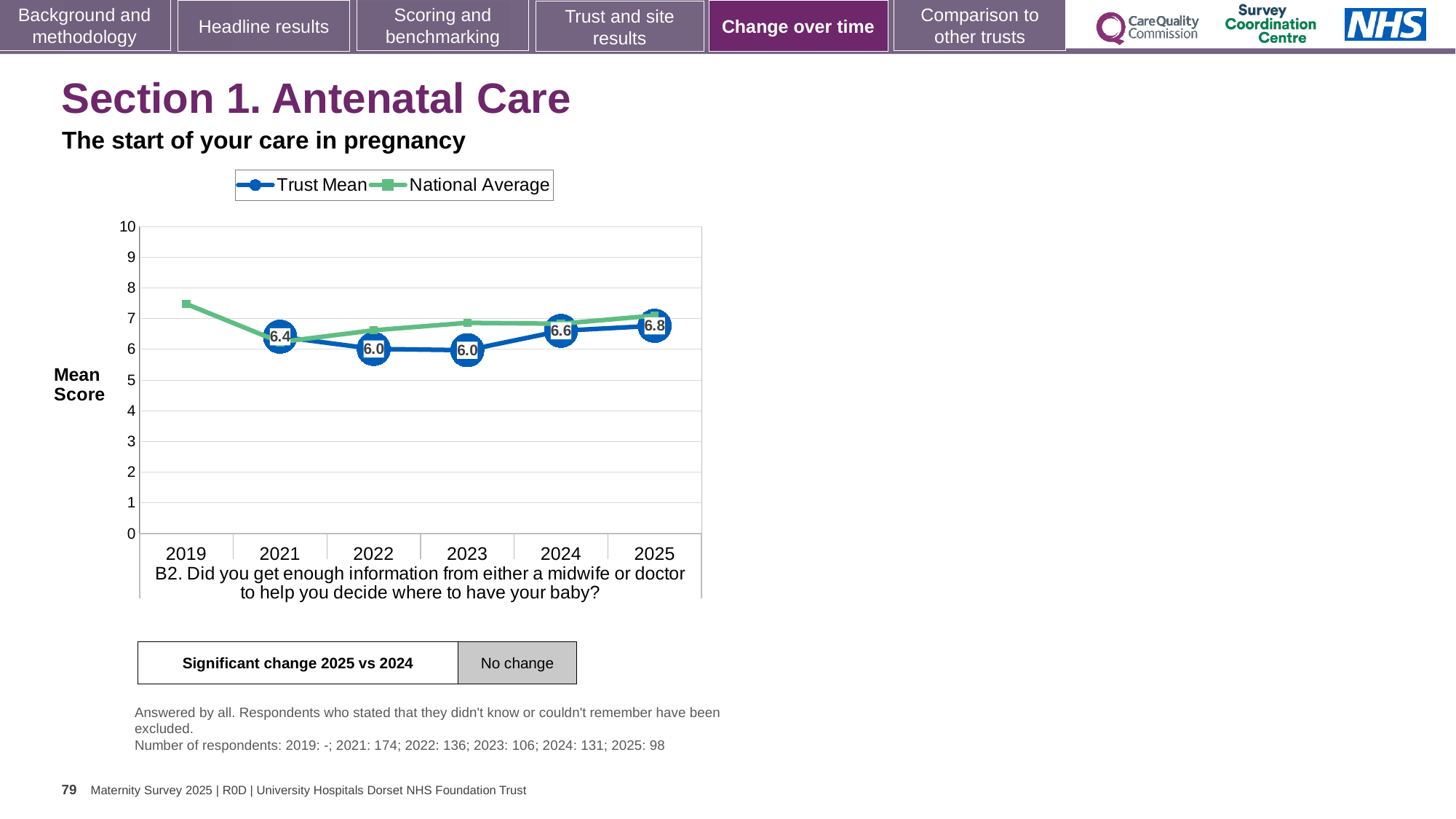
What is the Trust Mean score for 2021? 6.4 What is the difference between the Trust Mean scores for 2021 and 2022? 0.4 Which year has the larger Trust Mean score, 2022 or 2024? 2024 In which year is the Trust Mean score highest? 2025 What kind of chart is shown on the slide? Line chart What is the Trust Mean score for 2023? 6.0 How many years are shown on the x axis of the chart? 6 Is the National Average value for 2021 greater or less than 7? less What is the Trust Mean score for 2025? 6.8 What is the difference between the Trust Mean scores for 2025 and 2024? 0.2 Is the National Average value for 2019 greater or less than 7? greater How many series does the chart legend list? 2